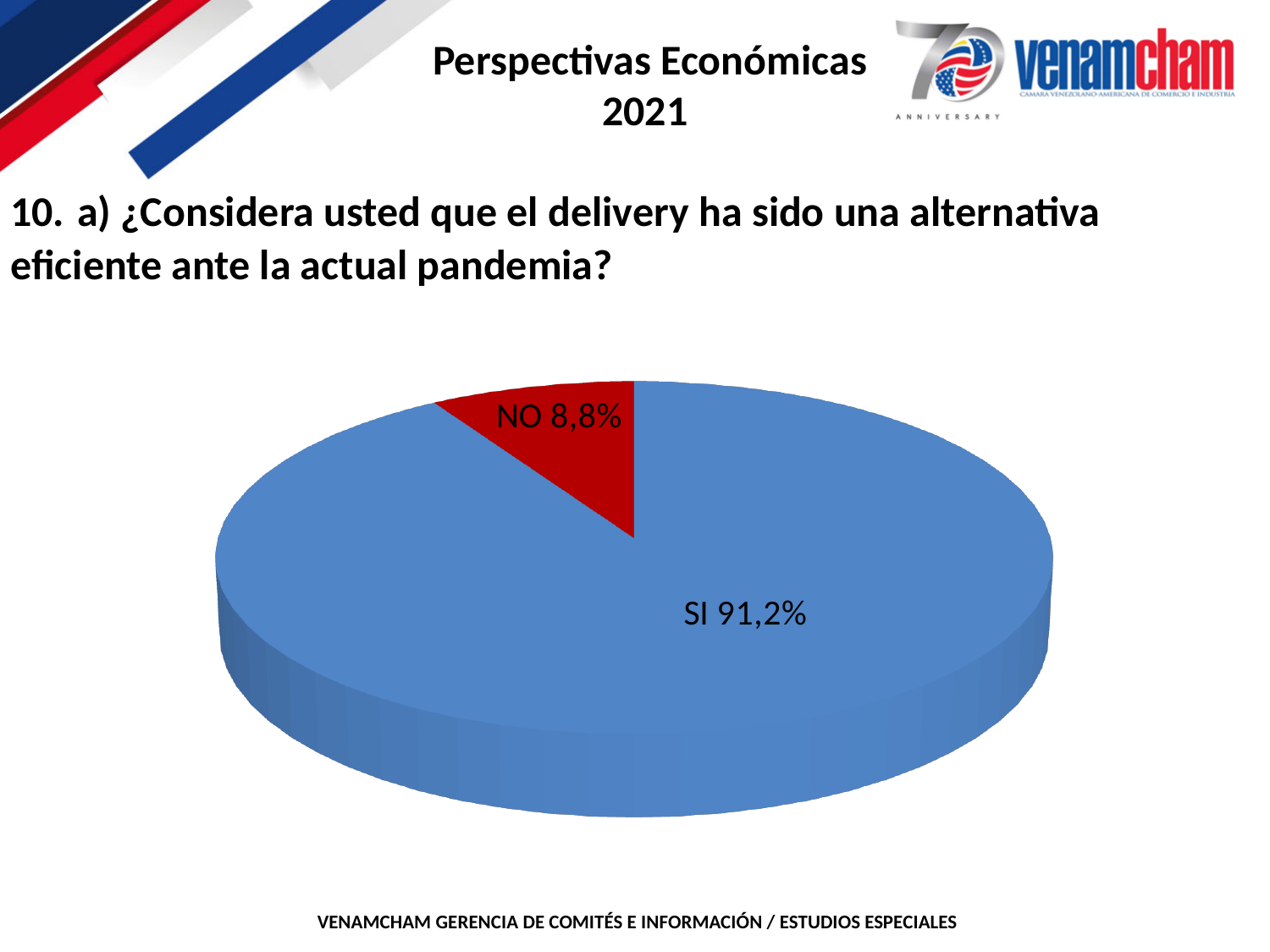
What is the difference in percentage points between the SI and NO slices? 82,4 Which is larger, the SI slice or the NO slice? SI What share of the pie does the NO slice represent? 8,8% What colour is the NO slice? Red How many slices does the pie chart have? 2 What percentage of respondents answered NO? 8,8% Which response has the smallest share of the pie? NO Which response has the largest share of the pie? SI What percentage of respondents answered SI? 91,2% What kind of chart is shown on the slide? Pie chart What colour is the SI slice? Blue